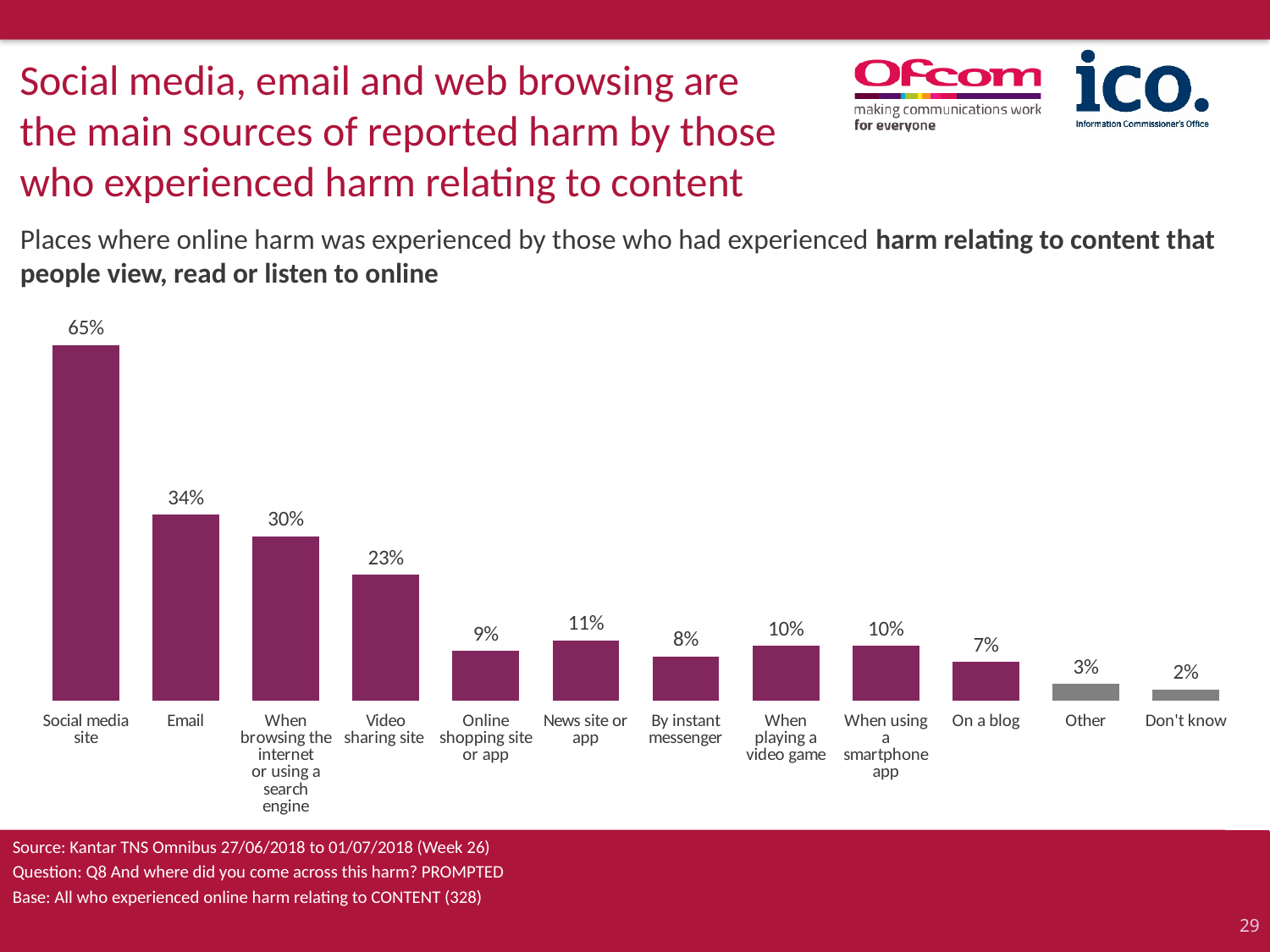
What is the value for 'When browsing the internet or using a search engine'? 30% What percentage of respondents experienced harm on a social media site? 65% What is the value for 'On a blog'? 7% What kind of chart is shown on the slide? Bar chart Which two categories are shown in grey bars rather than the dark red colour? Other and Don't know What is the difference between the values for Video sharing site and News site or app? 12% Which is larger, the value for Online shopping site or app or the value for News site or app? News site or app What is the value for Email? 34% What is the difference between the values for Social media site and Email? 31% Which category has the highest value? Social media site Which category has the lowest value? Don't know How many categories are shown in the chart? 12